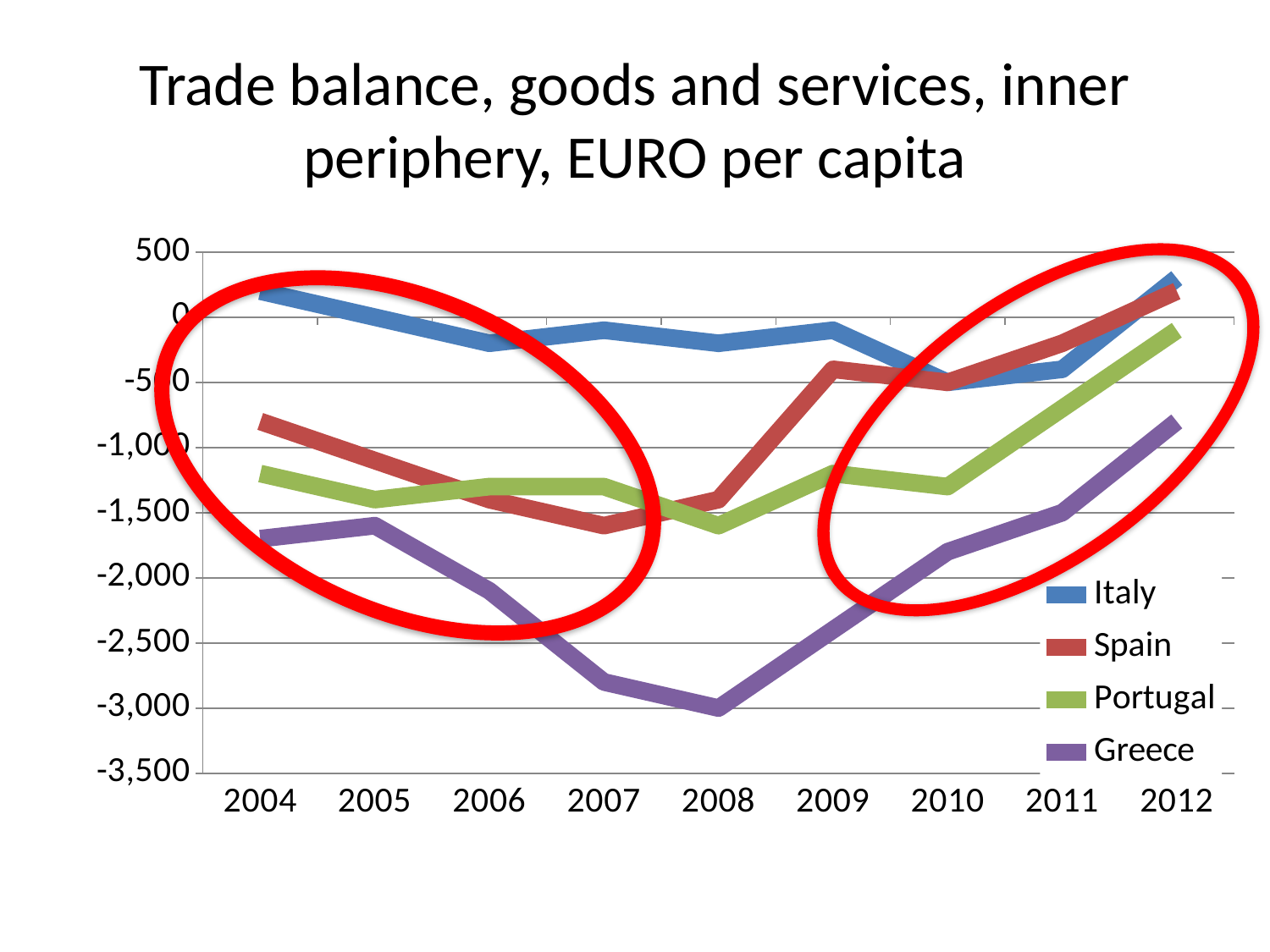
Is the value for Portugal in 2008 greater or less than -1,500? less How many series does the legend list? 4 Is the value for Spain in 2004 greater or less than -1,000? greater Is the value for Italy in 2004 greater or less than 0? greater What colour is the line for Greece? purple How many years are shown along the x axis? 9 What kind of chart is shown on the slide? line chart Which is larger in 2007, the value for Spain or the value for Portugal? Portugal Does the Greece line rise or fall from 2008 to 2012? rise Which country has the lowest trade balance in 2008? Greece Which country has the highest trade balance in 2008? Italy